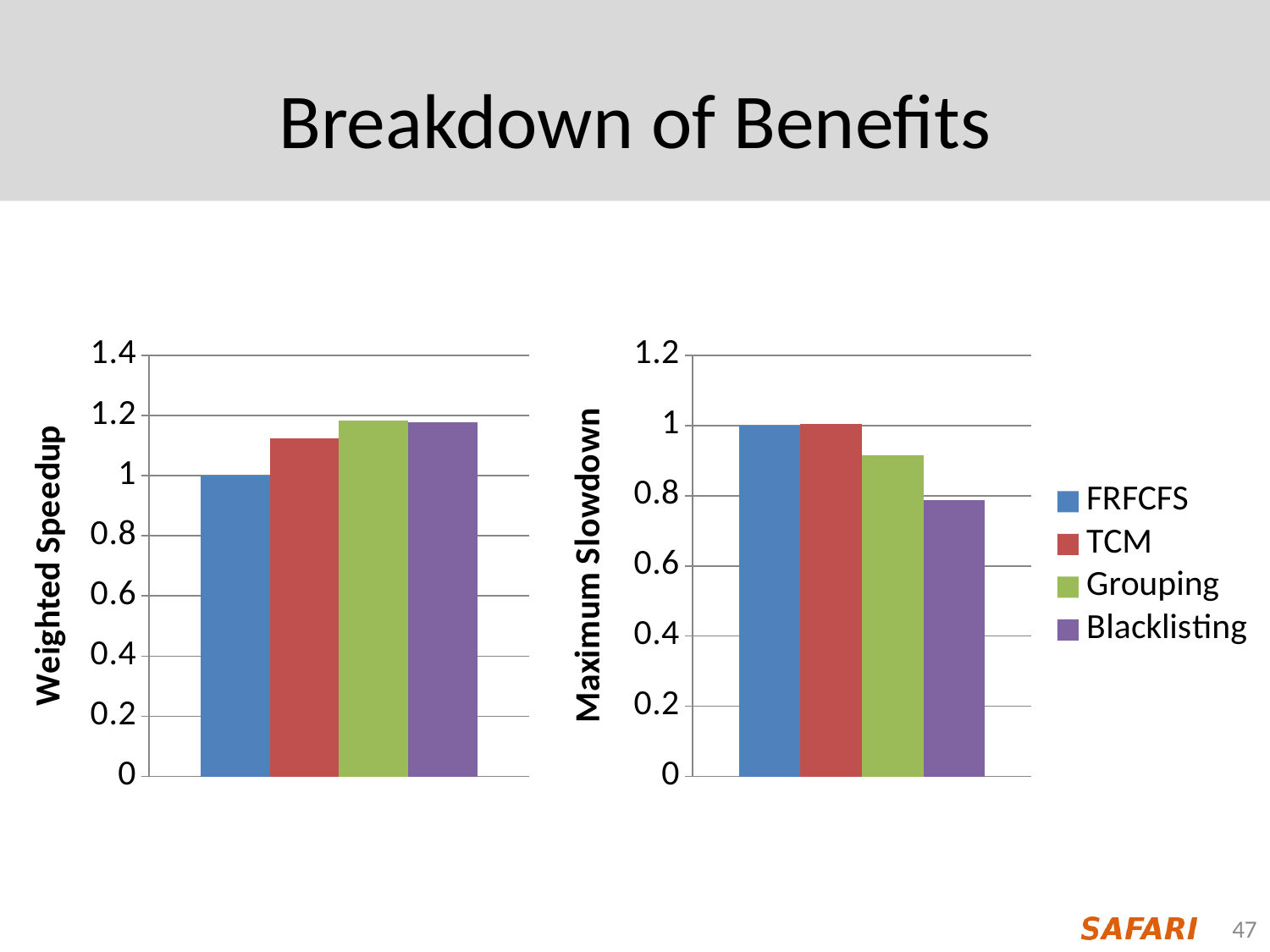
In the Maximum Slowdown chart, which is larger, Grouping or Blacklisting? Grouping In the Maximum Slowdown chart, which series has the lowest value? Blacklisting How many series does the legend list? 4 In the Maximum Slowdown chart, is the value for Grouping greater or less than 1? less In the Maximum Slowdown chart, is the value for Blacklisting greater or less than 1? less What is the y-axis label of the chart on the right? Maximum Slowdown In the Weighted Speedup chart, is the value for TCM greater or less than 1? greater In the Weighted Speedup chart, which series has the lowest value? FRFCFS What kind of chart is the Weighted Speedup chart on the left? bar chart In the Weighted Speedup chart, what is the value for FRFCFS? 1 In the Maximum Slowdown chart, what is the value for FRFCFS? 1